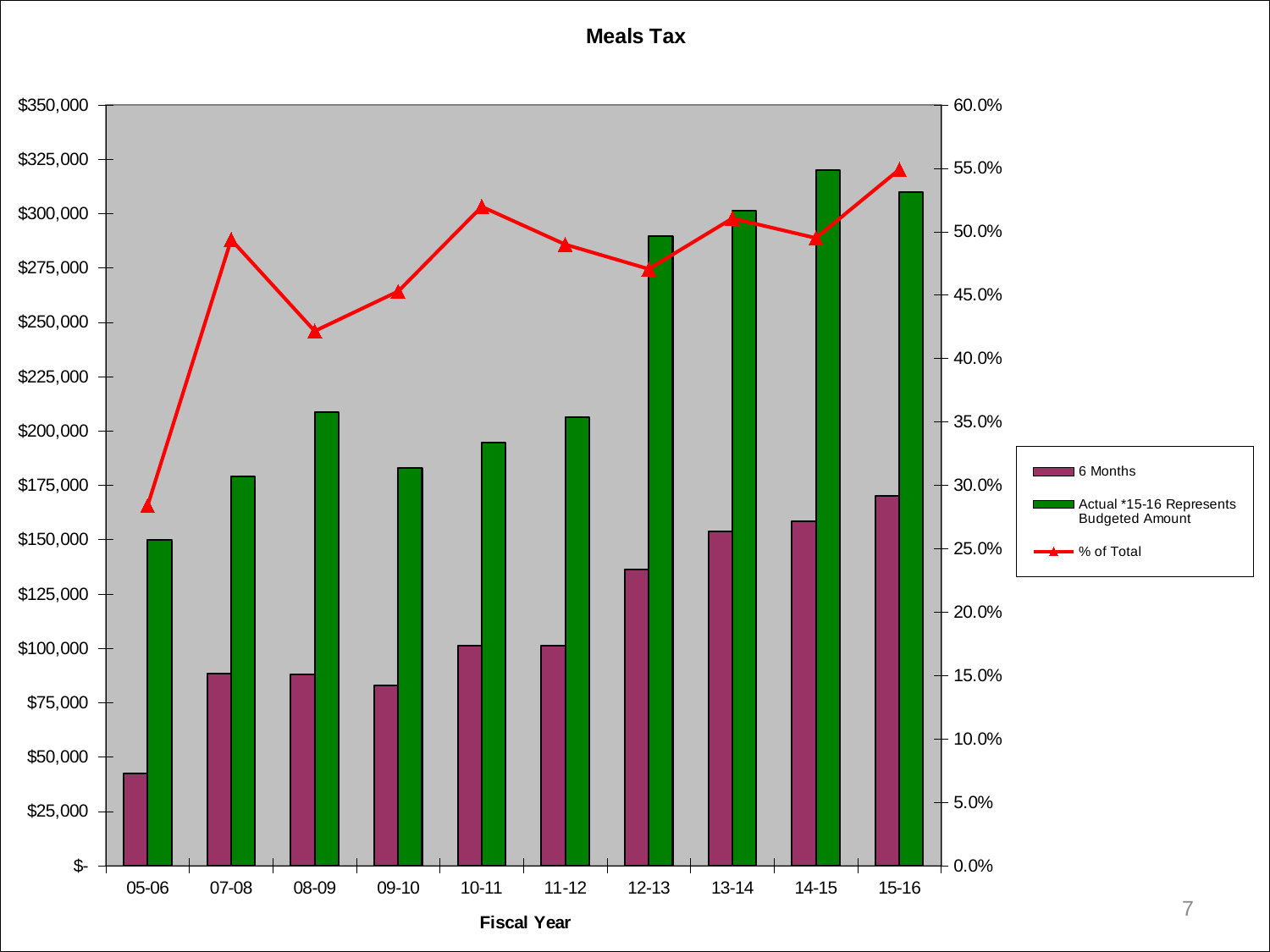
Which fiscal year has the highest 6 Months bar? 15-16 What is the title of the x axis on the Meals Tax chart? Fiscal Year Which fiscal year has the lowest Actual bar? 05-06 How many series does the legend of the Meals Tax chart list? 3 In which fiscal year is the % of Total line at its lowest point? 05-06 Which is larger, the Actual value for 08-09 or for 09-10? 08-09 Is the 6 Months value for 05-06 greater or less than $50,000? less What kind of chart is shown on the slide? A bar chart combined with a line How many fiscal years are shown on the x axis of the Meals Tax chart? 10 Which fiscal year has the highest Actual bar? 14-15 Is the Actual value for 12-13 greater or less than $275,000? greater Which fiscal year has the lowest 6 Months bar? 05-06